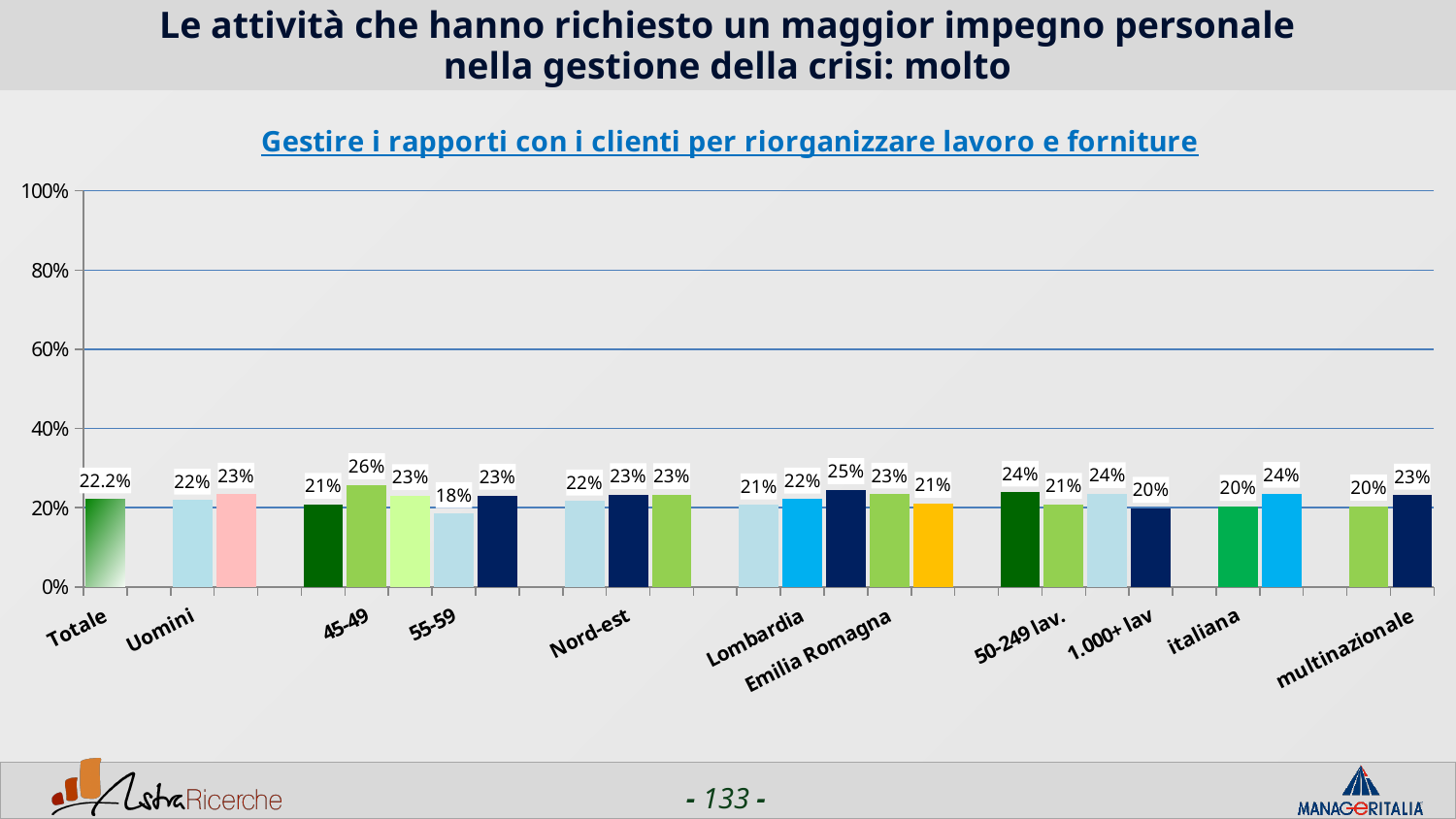
What is the difference between the values for 45-49 and 55-59? 8 percentage points What is the value for the 45-49 age group? 26% What is the value for Nord-est? 23% What is the value for Uomini? 22% Is the value for Totale greater or less than 40%? less What is the value for Totale? 22.2% What is the value for the 55-59 age group? 18% What type of chart is shown on the slide? bar chart Which is larger, the value for 45-49 or the value for 55-59? 45-49 Which labelled category has the lowest value? 55-59 Which labelled category has the highest value? 45-49 What is the value for 1.000+ lav? 20%